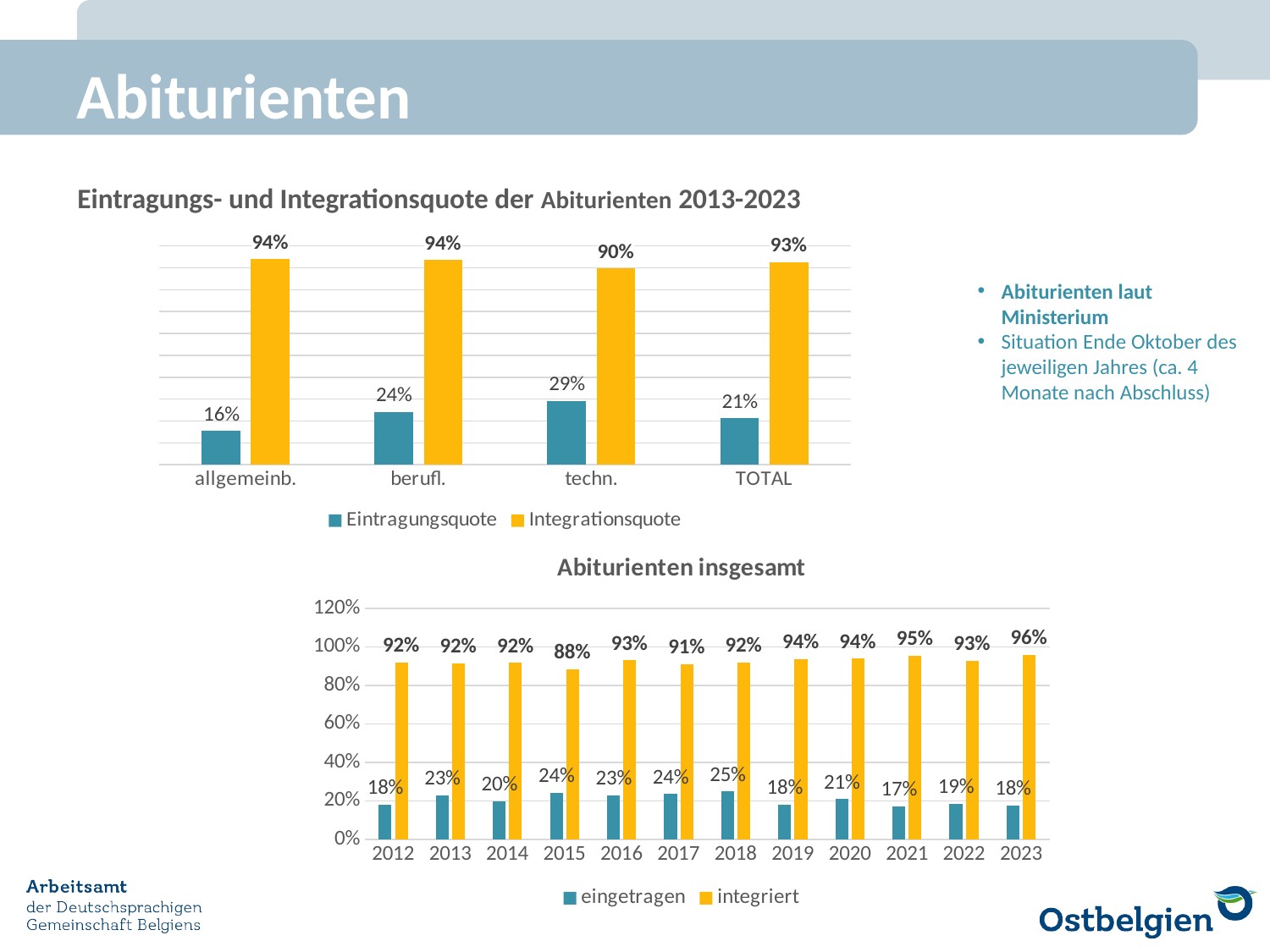
In the bottom chart (Abiturienten insgesamt), which year has the highest integriert value? 2023 What kind of chart is the bottom chart (Abiturienten insgesamt)? bar chart In the bottom chart (Abiturienten insgesamt), what is the eingetragen value for 2018? 25% In the bottom chart (Abiturienten insgesamt), is the eingetragen value for 2013 larger or smaller than the eingetragen value for 2019? larger In the bottom chart (Abiturienten insgesamt), what is the integriert value for 2015? 88% In the top chart (Eintragungs- und Integrationsquote der Abiturienten 2013-2023), what is the Integrationsquote for TOTAL? 93% In the top chart (Eintragungs- und Integrationsquote der Abiturienten 2013-2023), what is the difference between the Integrationsquote and the Eintragungsquote for berufl.? 70 percentage points In the bottom chart (Abiturienten insgesamt), how many years are shown on the x axis? 12 In the top chart (Eintragungs- und Integrationsquote der Abiturienten 2013-2023), which category has the lowest Eintragungsquote? allgemeinb. In the top chart (Eintragungs- und Integrationsquote der Abiturienten 2013-2023), what is the Eintragungsquote for techn.? 29% In the bottom chart (Abiturienten insgesamt), which year has the lowest eingetragen value? 2021 In the top chart (Eintragungs- und Integrationsquote der Abiturienten 2013-2023), how many series does the legend list? 2